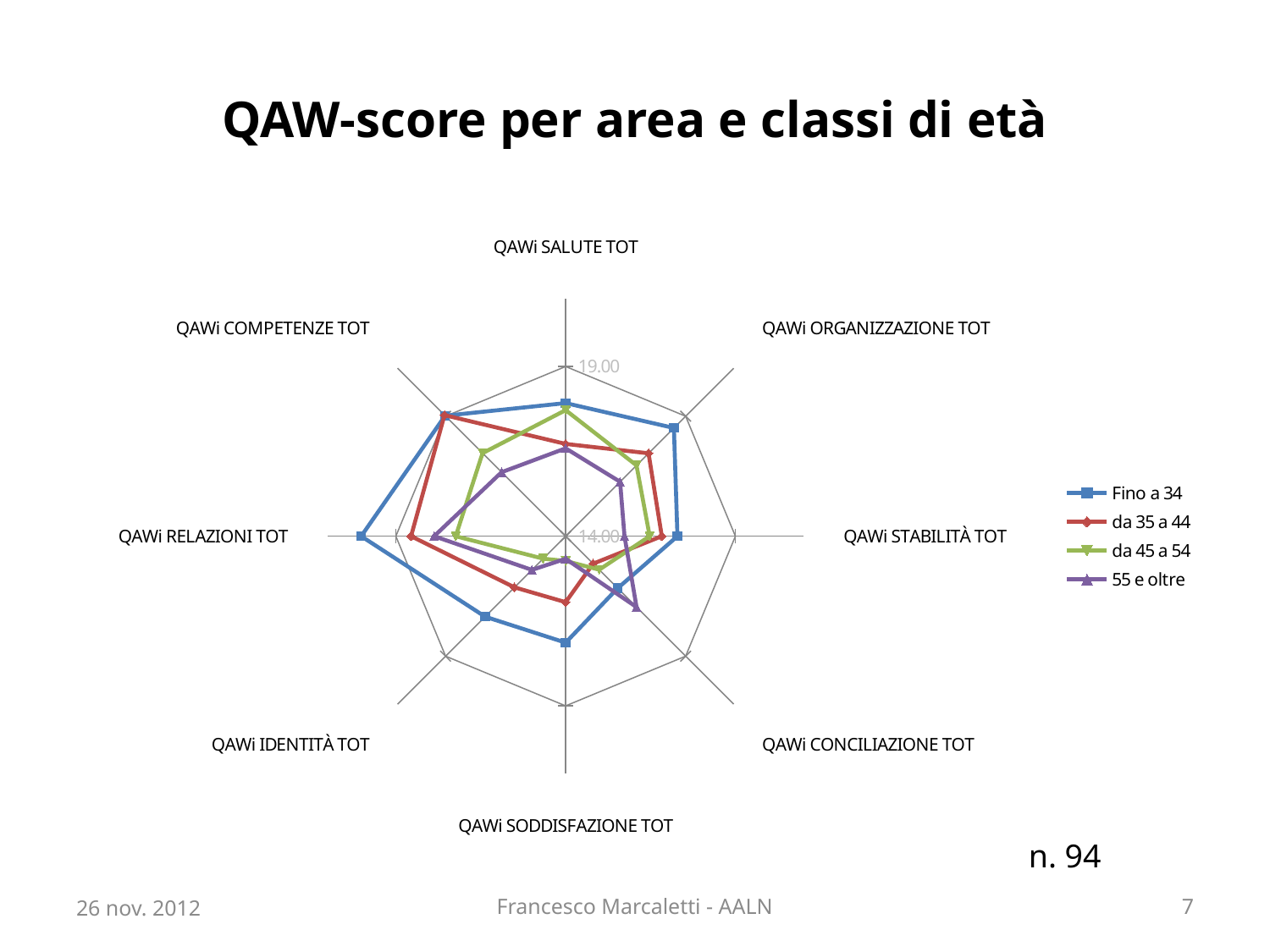
Is the value for Fino a 34 on QAWi SALUTE TOT greater or less than 19.00? less How many series does the legend list? 4 Which series is represented by the blue line with square markers? Fino a 34 What is the title of the chart on the slide? QAW-score per area e classi di età For the series Fino a 34, which category has the highest value? QAWi RELAZIONI TOT What kind of chart is shown on the slide? Radar chart For QAWi CONCILIAZIONE TOT, which is larger: the value for 55 e oltre or the value for da 45 a 54? 55 e oltre For the series Fino a 34, which category has the lowest value? QAWi CONCILIAZIONE TOT Which series has the highest value for QAWi RELAZIONI TOT? Fino a 34 Which series has the lowest value for QAWi SALUTE TOT? 55 e oltre Is the value for Fino a 34 on QAWi RELAZIONI TOT greater or less than 19.00? greater How many categories (axes) does the radar chart have? 8